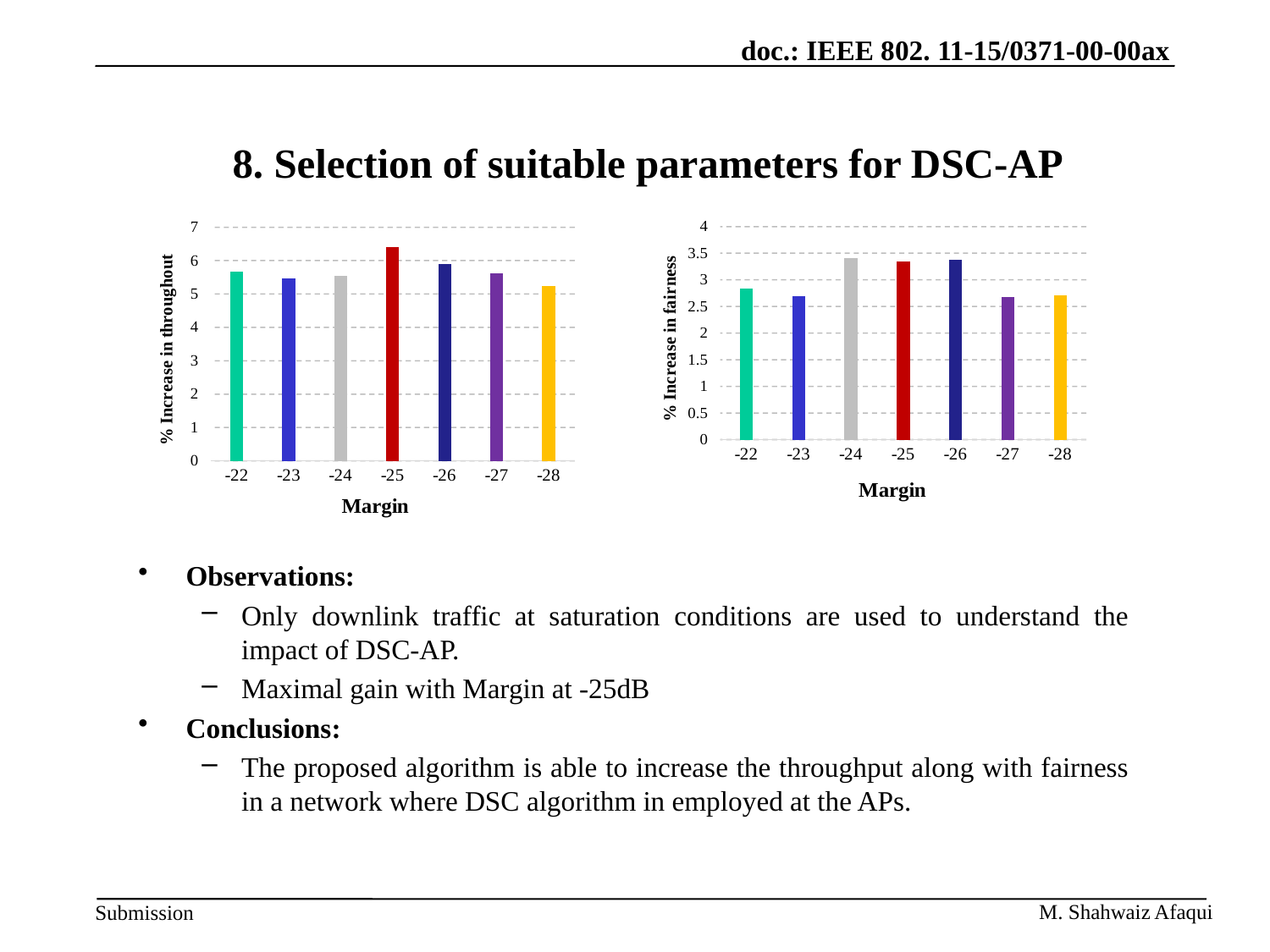
In the right chart (% Increase in fairness), is the value for Margin -27 greater or less than 3? less What kind of chart is the left chart (% Increase in throughout)? bar chart How many Margin categories are shown in the right chart (% Increase in fairness)? 7 In the left chart (% Increase in throughout), which is larger, the value for Margin -25 or Margin -23? -25 In the left chart (% Increase in throughout), which Margin value has the highest bar? -25 What is the x-axis title of the right chart (% Increase in fairness)? Margin In the left chart (% Increase in throughout), is the value for Margin -28 greater or less than 6? less How many Margin categories are shown in the left chart (% Increase in throughout)? 7 In the right chart (% Increase in fairness), which is larger, the value for Margin -24 or Margin -22? -24 In the right chart (% Increase in fairness), is the value for Margin -24 greater or less than 3? greater In the left chart (% Increase in throughout), which is larger, the value for Margin -26 or Margin -28? -26